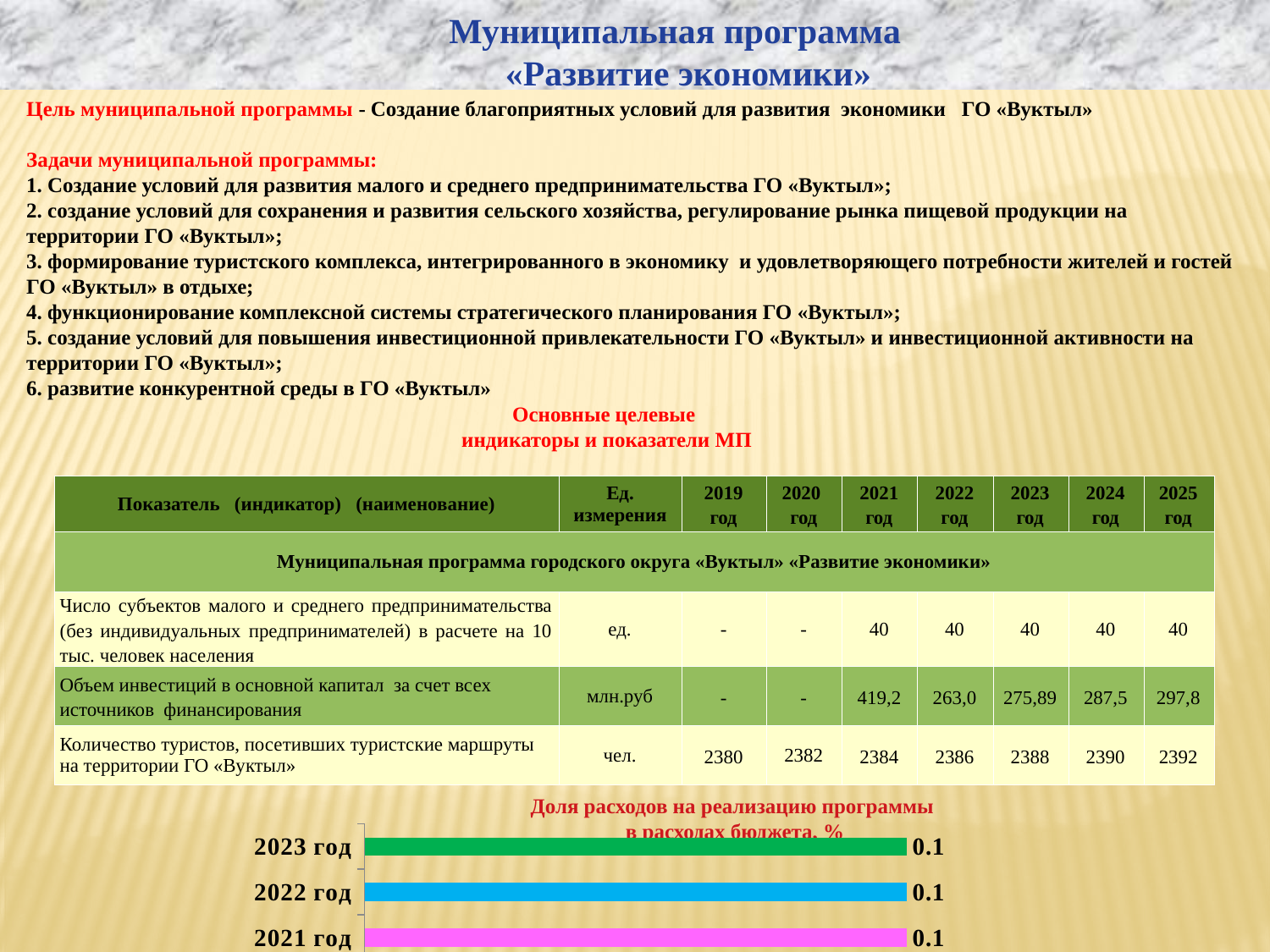
How many bars (categories) are shown in the chart? 3 What is the title of the chart? Доля расходов на реализацию программы в расходах бюджета, % Do the values in the chart rise, fall, or stay the same from 2021 год to 2023 год? stay the same What is the value for 2022 год in the chart? 0.1 What is the value for 2021 год in the chart? 0.1 What is the value for 2023 год in the chart? 0.1 What is the difference between the values for 2023 год and 2021 год in the chart? 0 What type of chart is shown at the bottom of the slide? bar chart What colour is the bar for 2022 год in the chart? blue